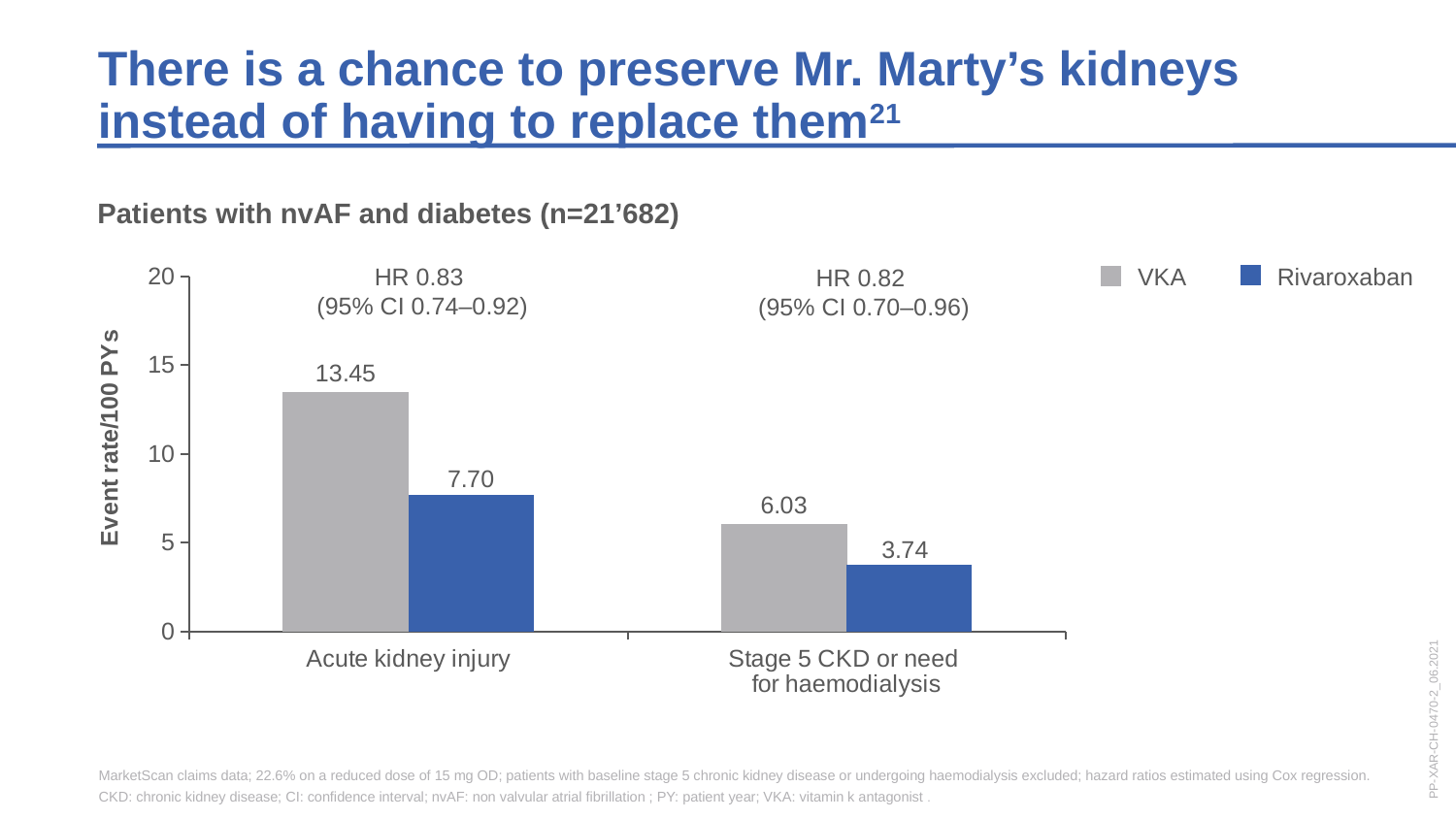
Which bar has the lowest event rate on the chart? Rivaroxaban, Stage 5 CKD or need for haemodialysis What is the event rate per 100 PYs for VKA in the Stage 5 CKD or need for haemodialysis category? 6.03 What kind of chart is shown on the slide? Bar chart Which is larger: the Rivaroxaban event rate for Acute kidney injury or the VKA event rate for Stage 5 CKD or need for haemodialysis? Rivaroxaban event rate for Acute kidney injury What is the event rate per 100 PYs for Rivaroxaban in the Stage 5 CKD or need for haemodialysis category? 3.74 What is the event rate per 100 PYs for Rivaroxaban in the Acute kidney injury category? 7.70 What is the difference between the VKA and Rivaroxaban event rates for Stage 5 CKD or need for haemodialysis? 2.29 What is the difference between the VKA and Rivaroxaban event rates for Acute kidney injury? 5.75 Which bar has the highest event rate on the chart? VKA, Acute kidney injury What is the event rate per 100 PYs for VKA in the Acute kidney injury category? 13.45 What hazard ratio is shown above the Stage 5 CKD or need for haemodialysis bars? HR 0.82 (95% CI 0.70–0.96) How many series does the legend list? 2